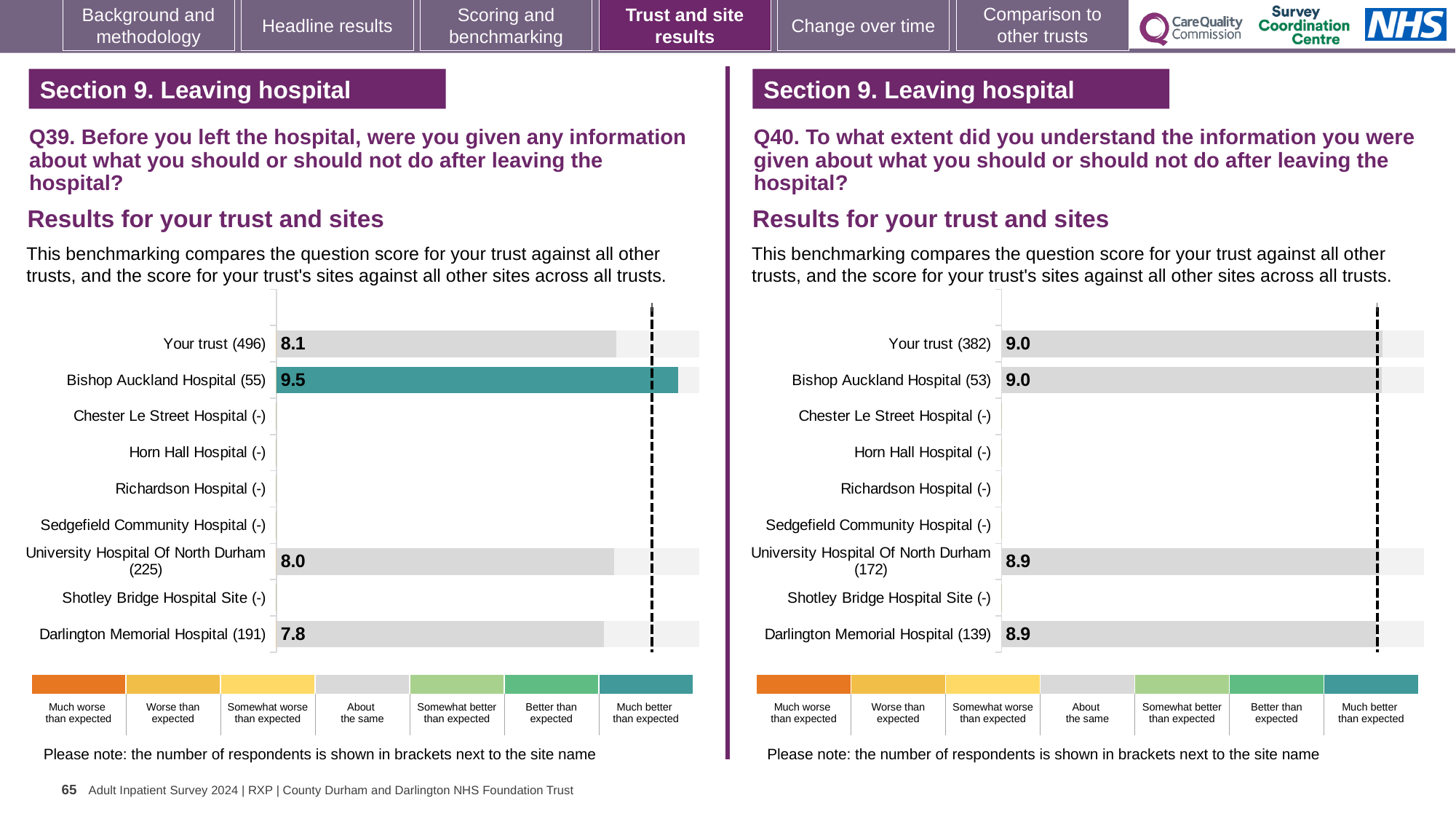
On the Q40 chart (right), what is the score for University Hospital Of North Durham? 8.9 On the Q39 chart (left), what is the score for Darlington Memorial Hospital? 7.8 On the Q39 chart (left), which site or trust row has the highest score? Bishop Auckland Hospital On the Q40 chart (right), how many rows (trust and sites) are listed on the vertical axis? 9 On the Q40 chart (right), what is the score for Your trust? 9.0 On the Q39 chart (left), what is the difference between the Bishop Auckland Hospital score and the Your trust score? 1.4 On the Q39 chart (left), how many respondents are shown in brackets for Your trust? 496 On the Q39 chart (left), which site or trust row has the lowest score among those with a plotted value? Darlington Memorial Hospital On the Q39 chart (left), which is larger: the score for University Hospital Of North Durham or the score for Darlington Memorial Hospital? University Hospital Of North Durham On the Q39 chart (left), what is the score for Bishop Auckland Hospital? 9.5 On the Q40 chart (right), what is the difference between the Your trust score and the Darlington Memorial Hospital score? 0.1 What kind of chart is used on the Q39 chart (left)? Bar chart